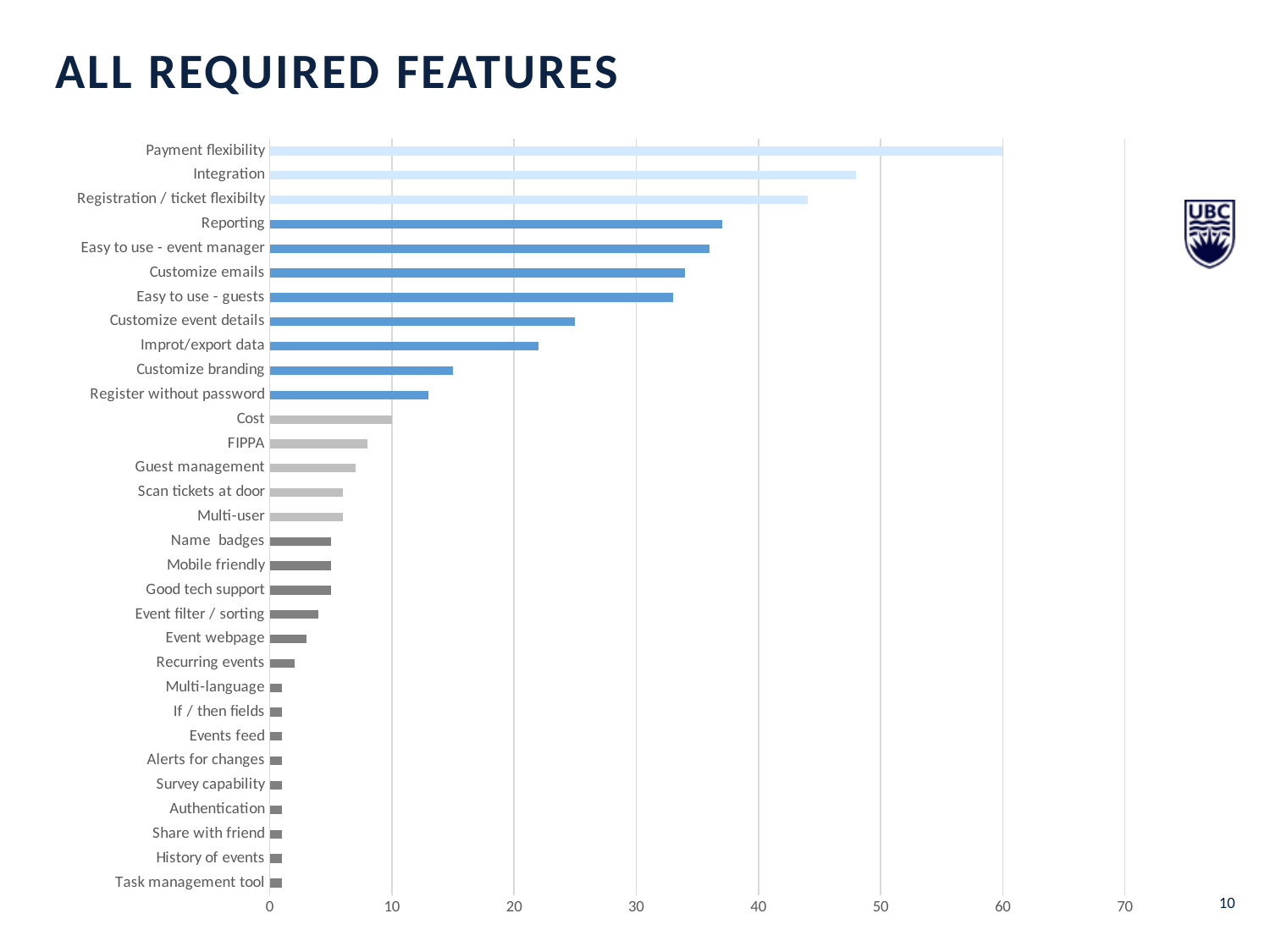
Is the value for Customize event details greater or less than 20? greater Are the bars ordered from largest to smallest going from top to bottom? yes Is the value for Customize branding greater or less than 10? greater What kind of chart is shown on the slide? bar chart What is the value for Payment flexibility? 60 Which has a larger value, Integration or Reporting? Integration Which feature has the highest value in the chart? Payment flexibility What is the value for Cost? 10 Is the value for Integration greater or less than 40? greater How many features (categories) are listed in the chart? 31